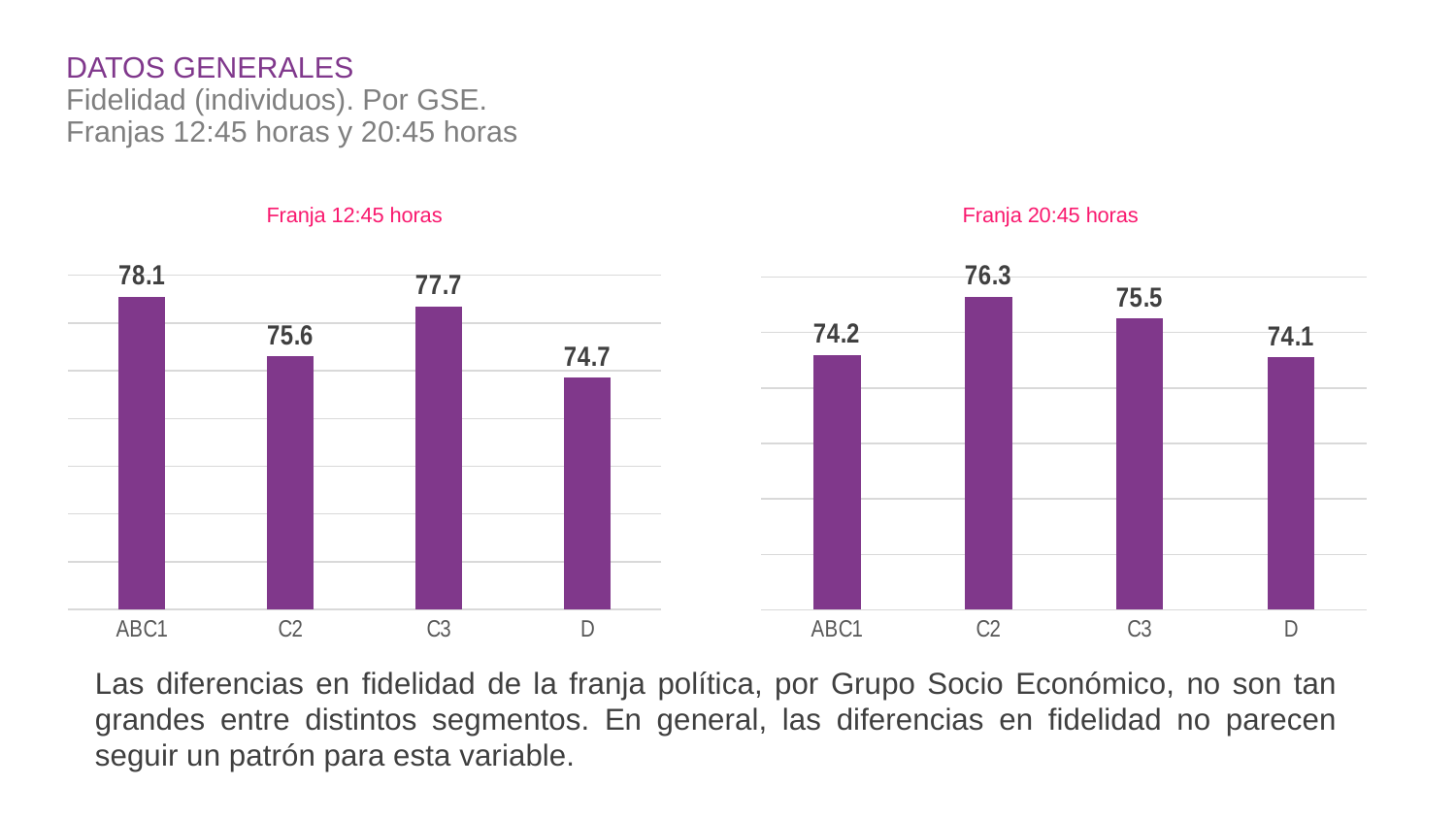
What is the title of the chart on the right side of the slide? Franja 20:45 horas In the 'Franja 20:45 horas' chart, which category has the lowest value? D In the 'Franja 12:45 horas' chart, what is the difference between the values for ABC1 and D? 3.4 In the 'Franja 20:45 horas' chart, what is the value for C3? 75.5 In the 'Franja 12:45 horas' chart, which category has the highest value? ABC1 What kind of chart is the 'Franja 12:45 horas' chart? Bar chart In the 'Franja 20:45 horas' chart, what is the difference between the values for C2 and ABC1? 2.1 In the 'Franja 12:45 horas' chart, which is larger, the value for C2 or the value for C3? C3 In the 'Franja 20:45 horas' chart, which category has the highest value? C2 In the 'Franja 12:45 horas' chart, what is the value for ABC1? 78.1 How many categories are shown in the 'Franja 20:45 horas' chart? 4 In the 'Franja 12:45 horas' chart, what is the value for D? 74.7